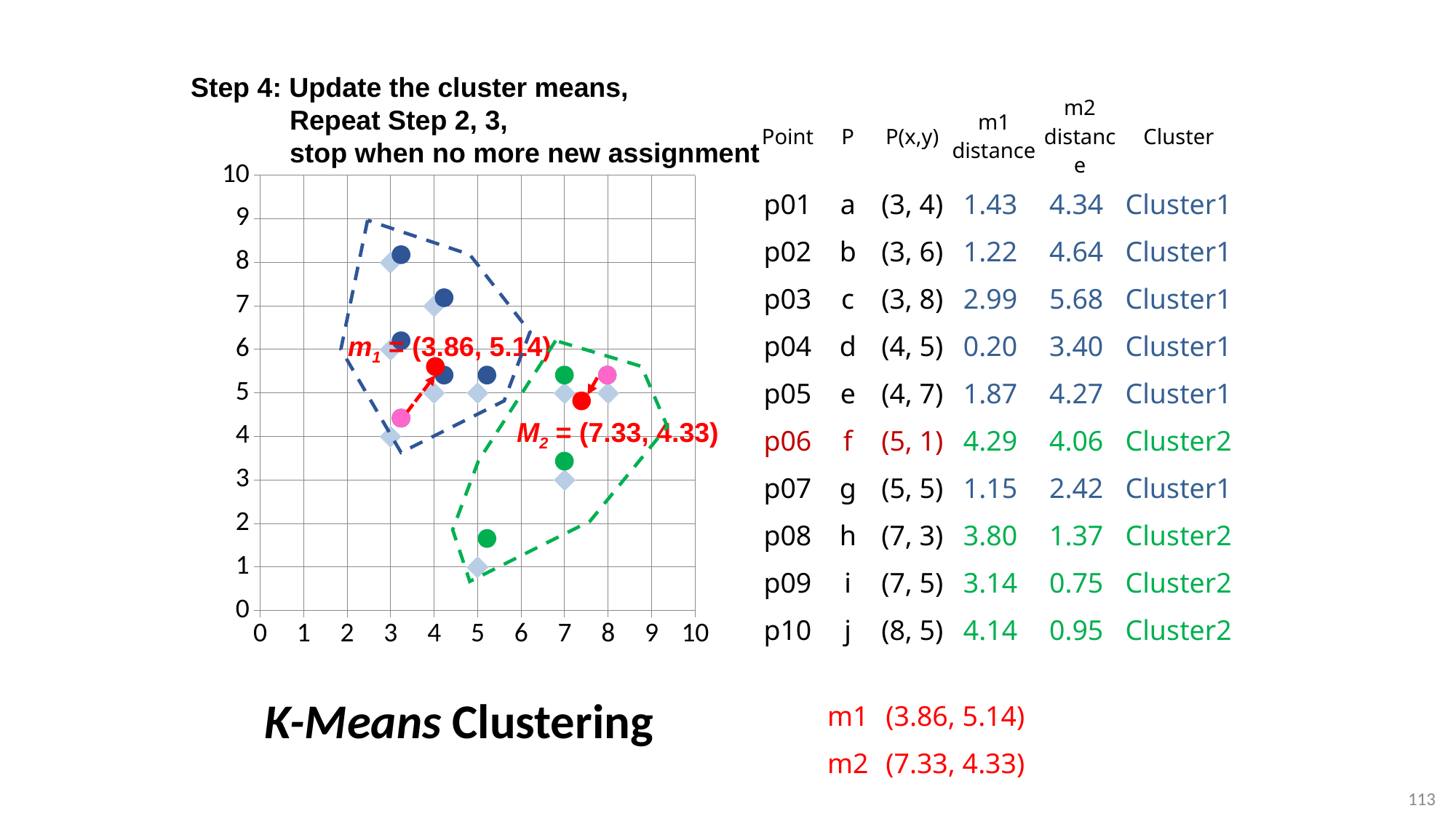
What is the maximum value shown on the chart's x axis? 10 Is the y-coordinate of M2 greater or less than 5? less Is the x-coordinate of m1 greater or less than 4? less How many dashed cluster outlines are drawn on the chart? 2 What are the coordinates of the cluster mean M2 labelled on the chart? (7.33, 4.33) What are the coordinates of the cluster mean m1 labelled on the chart? (3.86, 5.14) What is the difference between the y-coordinates of m1 and M2? 0.81 Which cluster mean has the larger y-coordinate, m1 or M2? m1 What kind of chart is shown on the slide? scatter chart Which cluster mean has the larger x-coordinate, m1 or M2? M2 What colour is the dashed outline enclosing the cluster around M2? green What is the difference between the x-coordinates of M2 and m1? 3.47